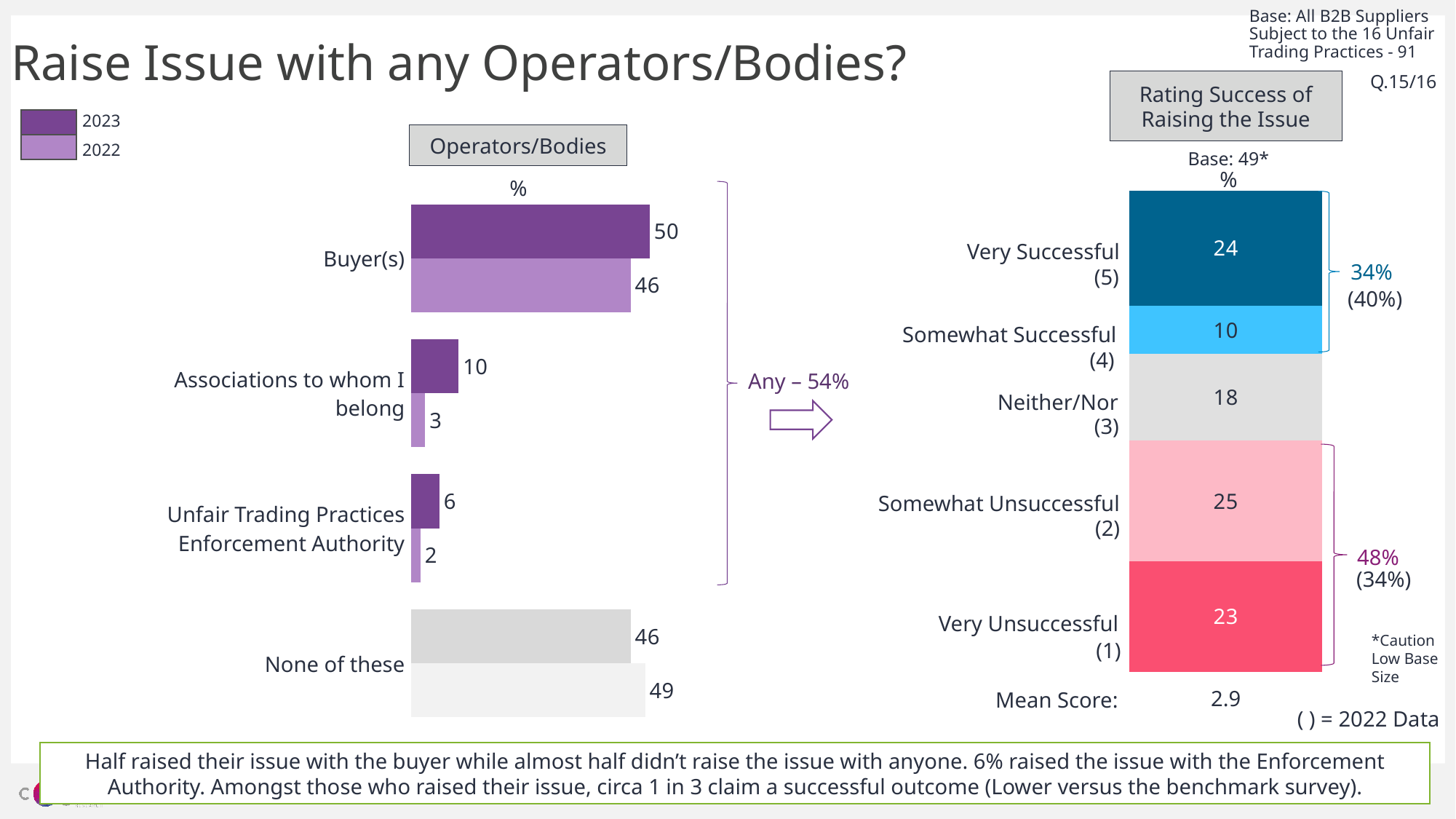
In the Operators/Bodies chart, which category has the highest 2023 value? Buyer(s) In the Rating Success of Raising the Issue chart, what is the value for Somewhat Unsuccessful (2)? 25 In the Rating Success of Raising the Issue chart, what is the Mean Score shown? 2.9 In the Operators/Bodies chart, what is the 2023 value for Buyer(s)? 50 In the Rating Success of Raising the Issue chart, which rating has the lowest value? Somewhat Successful (4) In the Operators/Bodies chart, what is the difference between the 2023 and 2022 values for Buyer(s)? 4 What kind of chart is the Operators/Bodies chart? bar chart In the Operators/Bodies chart, which category has the lowest 2022 value? Unfair Trading Practices Enforcement Authority In the Operators/Bodies chart, what is the 2023 value for Unfair Trading Practices Enforcement Authority? 6 How many series does the legend of the Operators/Bodies chart list? 2 In the Operators/Bodies chart, is the 2023 value for None of these larger or smaller than the 2022 value? smaller In the Operators/Bodies chart, what is the 2022 value for Associations to whom I belong? 3